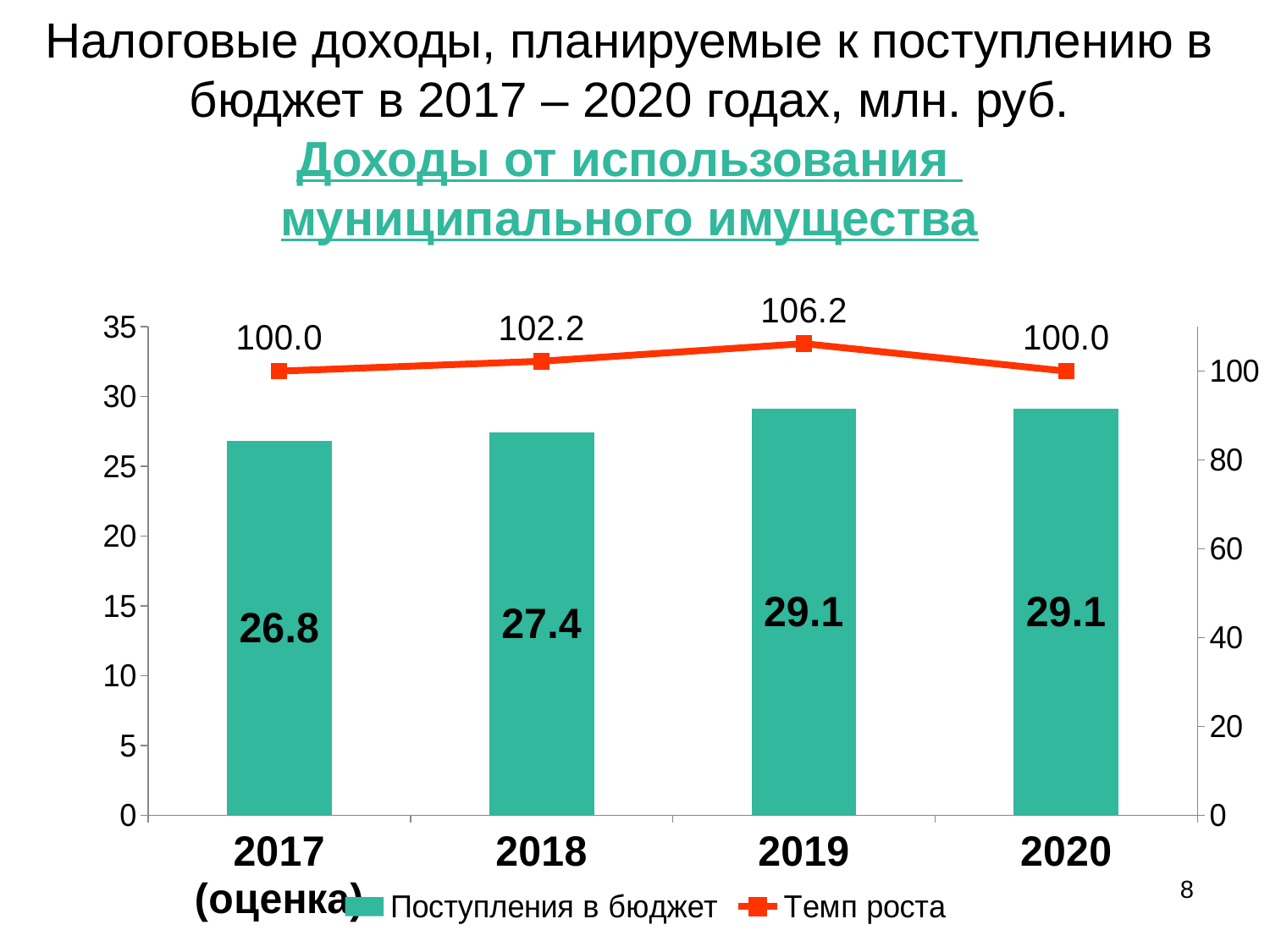
Which is larger, Поступления в бюджет in 2018 or in 2019? 2019 What is the Темп роста value for 2019? 106.2 What is the value of Поступления в бюджет for 2017 (оценка)? 26.8 Do the Поступления в бюджет values rise or fall from 2017 to 2019? Rise How many series does the legend list? 2 Which year has the lowest Поступления в бюджет value? 2017 (оценка) What is the value of Поступления в бюджет for 2018? 27.4 What is the Темп роста value for 2018? 102.2 How many years are shown on the x axis? 4 What is the difference between Поступления в бюджет in 2019 and in 2017? 2.3 Which year has the highest Темп роста value? 2019 What kind of chart is used for the Поступления в бюджет series? Bar chart